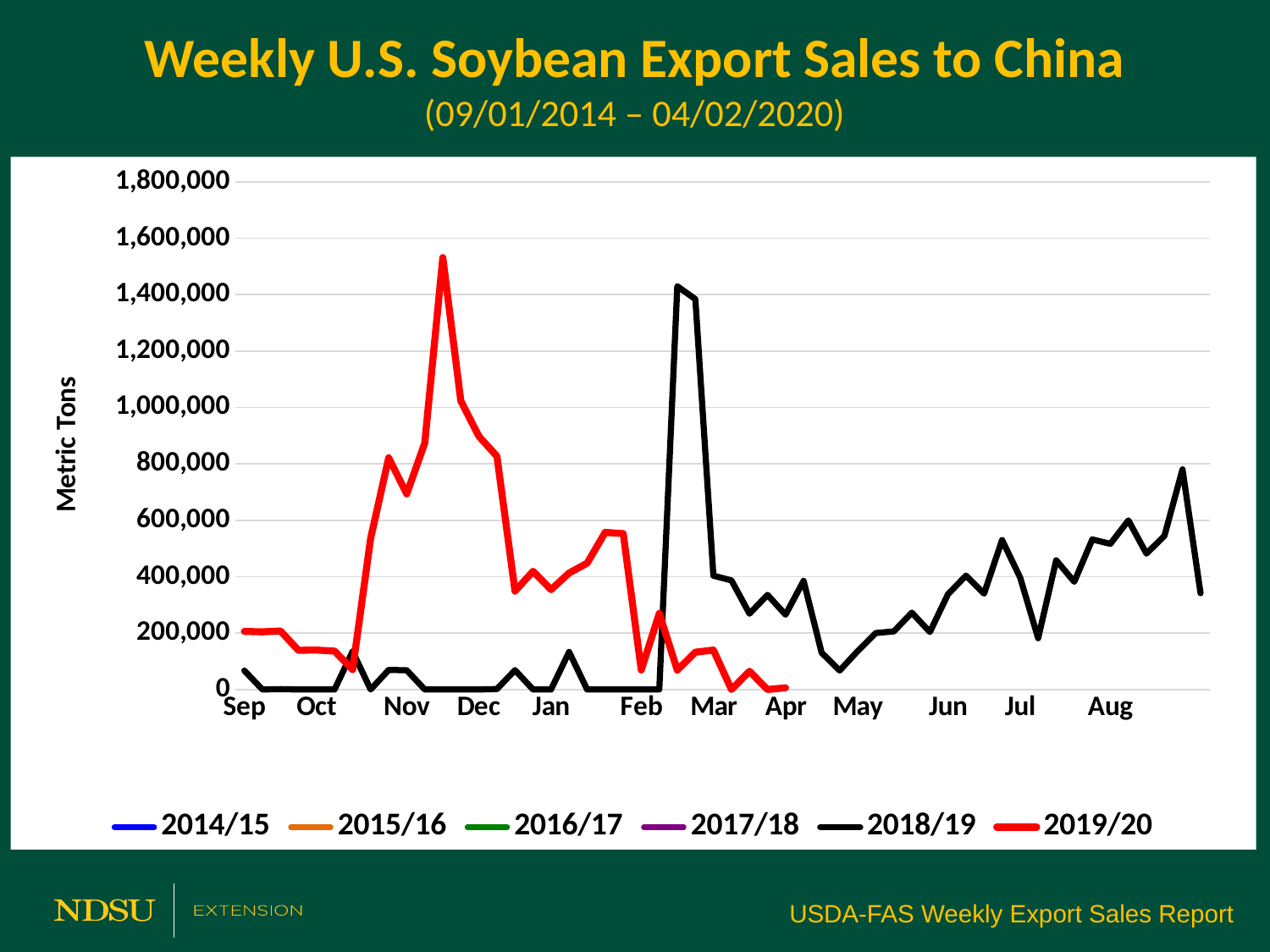
Is the highest value of the 2018/19 series in August greater or less than 600,000? greater How many series does the legend list? 6 What kind of chart is shown on the slide? line chart Is the peak value of the 2018/19 series (in February) greater or less than 1,200,000? greater How many month labels are shown along the x axis? 12 What is the label on the y axis? Metric Tons What is the title of the chart? Weekly U.S. Soybean Export Sales to China Does the 2019/20 series rise or fall from October to November? rise Which series reaches a higher peak value, 2018/19 or 2019/20? 2019/20 Is the peak value of the 2019/20 series (in November) greater or less than 1,400,000? greater Does the 2018/19 series rise or fall from its February peak to May? fall